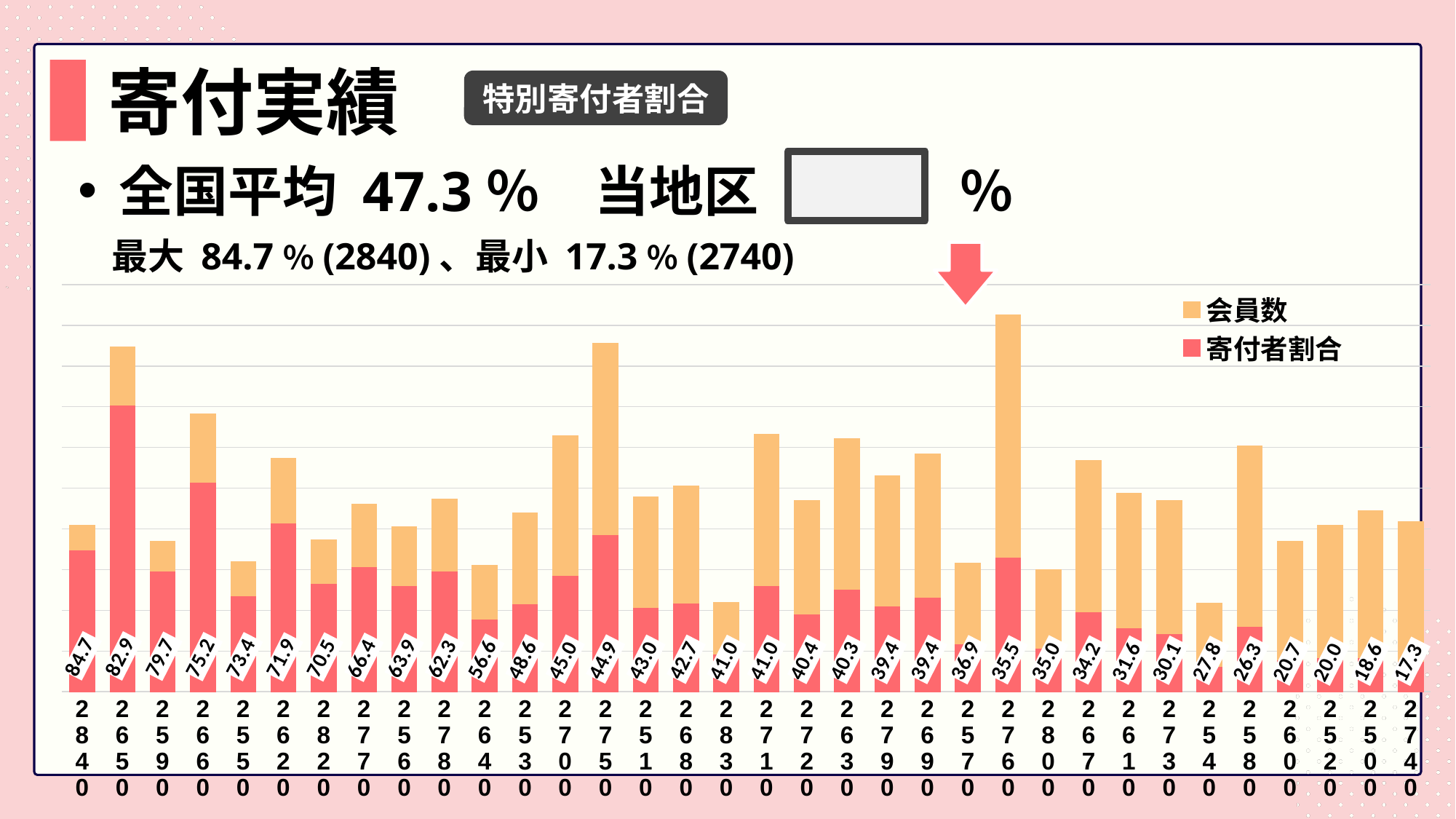
How many categories are shown on the x axis of the chart? 34 Which category has the highest 寄付者割合 value? 2840 What is the 寄付者割合 value labelled for category 2750? 44.9 What is the 寄付者割合 value labelled for category 2740? 17.3 How many series does the chart legend list? 2 Which category has the tallest 会員数 bar? 2760 Do the 寄付者割合 values rise or fall from left to right along the x axis? fall Which category has the lowest 寄付者割合 value? 2740 Which category has a larger 寄付者割合 value, 2590 or 2660? 2590 What is the 寄付者割合 value labelled for category 2840? 84.7 What is the difference between the 寄付者割合 values for 2840 and 2740? 67.4 What is the 寄付者割合 value labelled for category 2650? 82.9